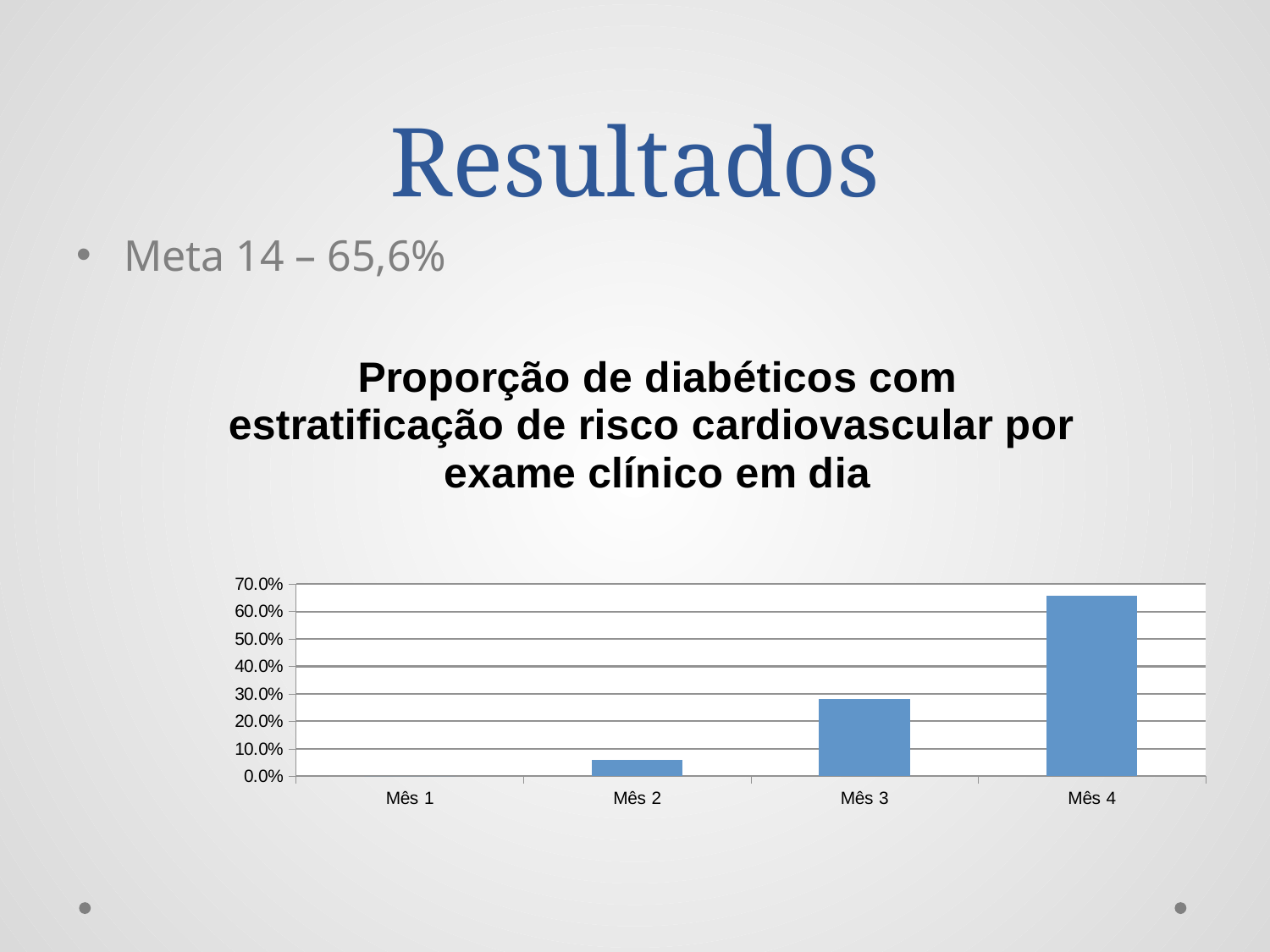
Do the values rise or fall from Mês 1 to Mês 4? rise How many categories are shown on the x axis of the chart? 4 What is the highest value shown on the y axis of the chart? 70.0% Which is larger, the value for Mês 2 or the value for Mês 3? Mês 3 Is the value for Mês 3 greater or less than 20.0%? greater Which month has the lowest value in the chart? Mês 1 What is the title of the chart? Proporção de diabéticos com estratificação de risco cardiovascular por exame clínico em dia Which month has the highest value in the chart? Mês 4 Is the value for Mês 2 greater or less than 10.0%? less Is the value for Mês 4 greater or less than 60.0%? greater What kind of chart is shown on the slide? bar chart